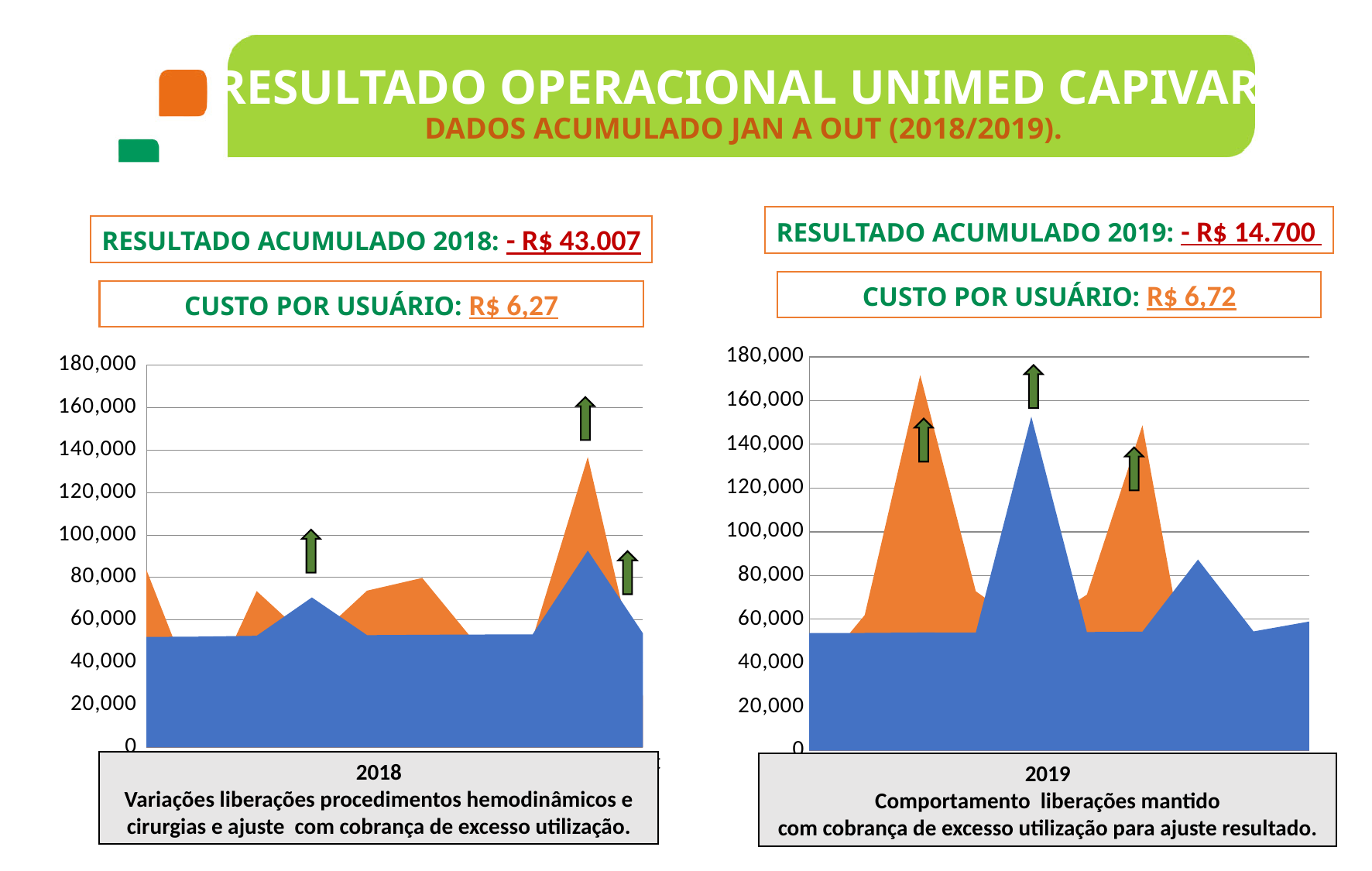
What is the main title of the slide above the two charts? RESULTADO OPERACIONAL UNIMED CAPIVAR What is the highest value shown on the vertical axis of the 2019 chart on the right? 180,000 In the 2019 chart on the right, is the highest point of the blue area greater or less than 140,000? greater In the 2018 chart on the left, is the highest point of the orange area greater or less than 140,000? less In the 2018 chart on the left, is the lowest value of the blue area greater or less than 40,000? greater In the 2019 chart on the right, which reaches a higher peak, the orange area or the blue area? The orange area What kind of chart is the chart labelled 2018 on the left? Area chart Which chart has the higher peak of the orange area, the 2018 chart or the 2019 chart? The 2019 chart How many charts are shown on the slide? 2